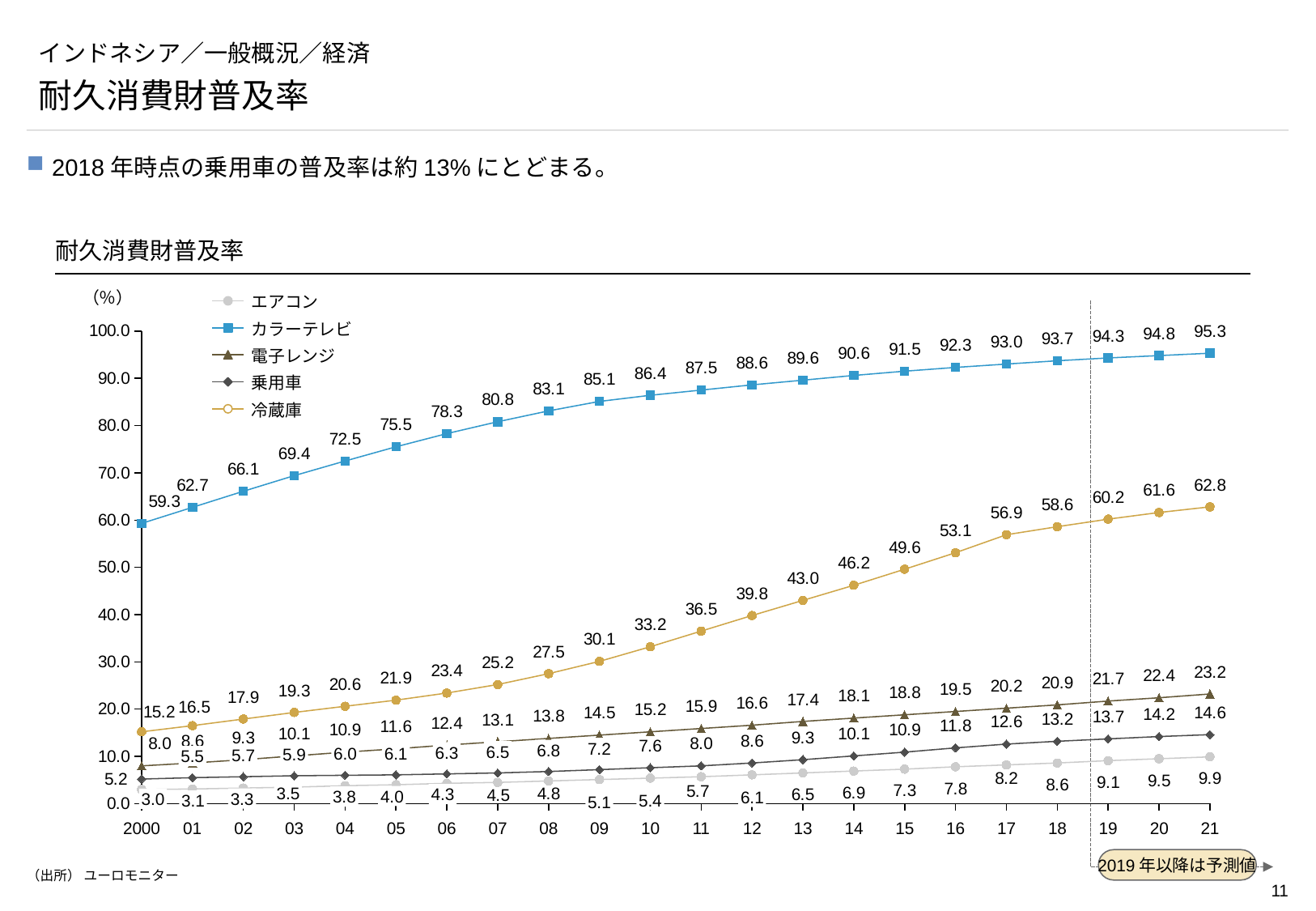
What is the value for カラーテレビ in 2000? 59.3 What is the value for 乗用車 in 2021? 14.6 Which series has the highest value in 2021? カラーテレビ What is the difference between the カラーテレビ values in 2021 and 2000? 36.0 Does the value for 冷蔵庫 rise or fall from 2000 to 2021? rise How many years are plotted along the x axis? 22 How many series does the legend list? 5 What type of chart is shown on the slide? line chart What is the value for エアコン in 2010? 5.4 What is the value for 冷蔵庫 in 2018? 58.6 Which is larger in 2015, the value for 電子レンジ or the value for 乗用車? 電子レンジ Which series has the lowest value in 2000? エアコン